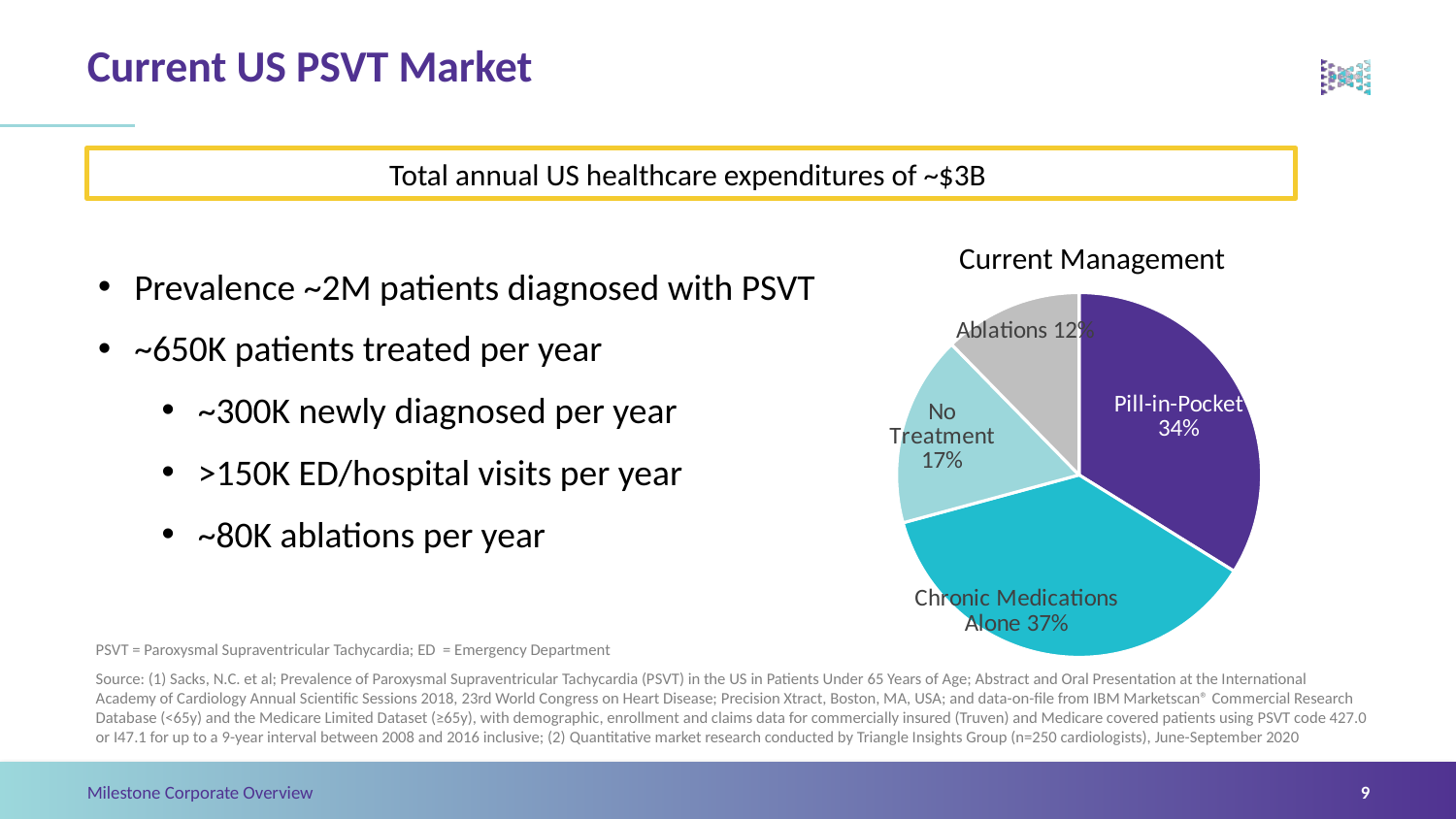
How many slices does the pie chart have? 4 What share of the pie is Chronic Medications Alone? 37% What kind of chart is shown on the slide? Pie chart Which slice of the pie chart is the largest? Chronic Medications Alone What share of the pie is Ablations? 12% What is the title of the chart? Current Management What is the difference in percentage points between Pill-in-Pocket and Ablations? 22 What share of the pie is No Treatment? 17% Which is larger, the No Treatment slice or the Ablations slice? No Treatment Which slice of the pie chart is the smallest? Ablations What is the difference in percentage points between Chronic Medications Alone and Pill-in-Pocket? 3